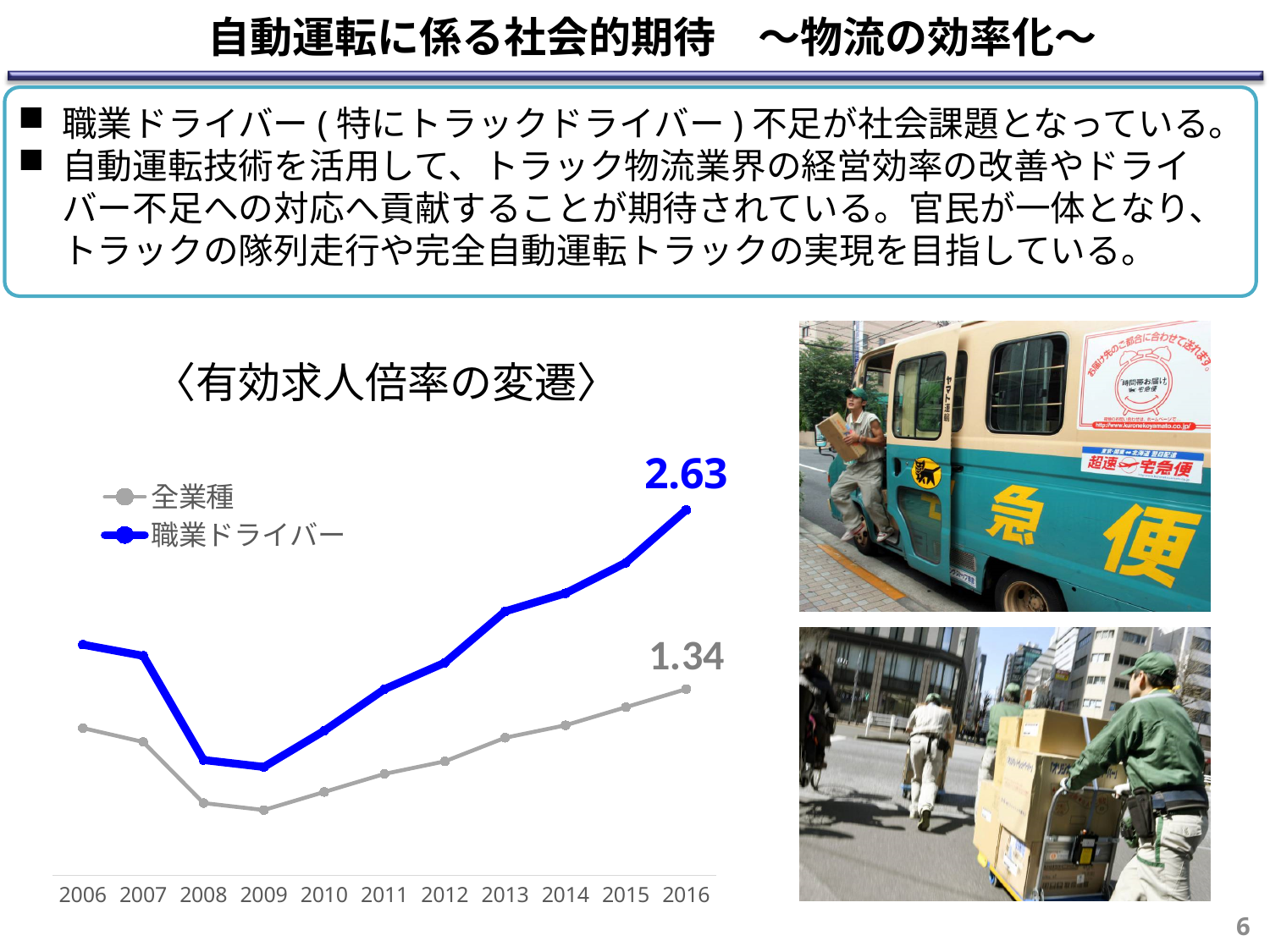
In which year does the 職業ドライバー series reach its highest value? 2016 What kind of chart is shown on the slide? Line chart In 2016, which series has the higher value, 職業ドライバー or 全業種? 職業ドライバー What is the value for 全業種 in 2016? 1.34 What is the title of the chart? 〈有効求人倍率の変遷〉 What is the value for 職業ドライバー in 2016? 2.63 In which year does the 全業種 series reach its highest value? 2016 How many series does the legend list? 2 Which colour is used for the 職業ドライバー line? Blue How many years are shown on the x axis of the chart? 11 What is the difference between the 職業ドライバー and 全業種 values in 2016? 1.29 Do the values for 職業ドライバー rise or fall from 2009 to 2016? Rise